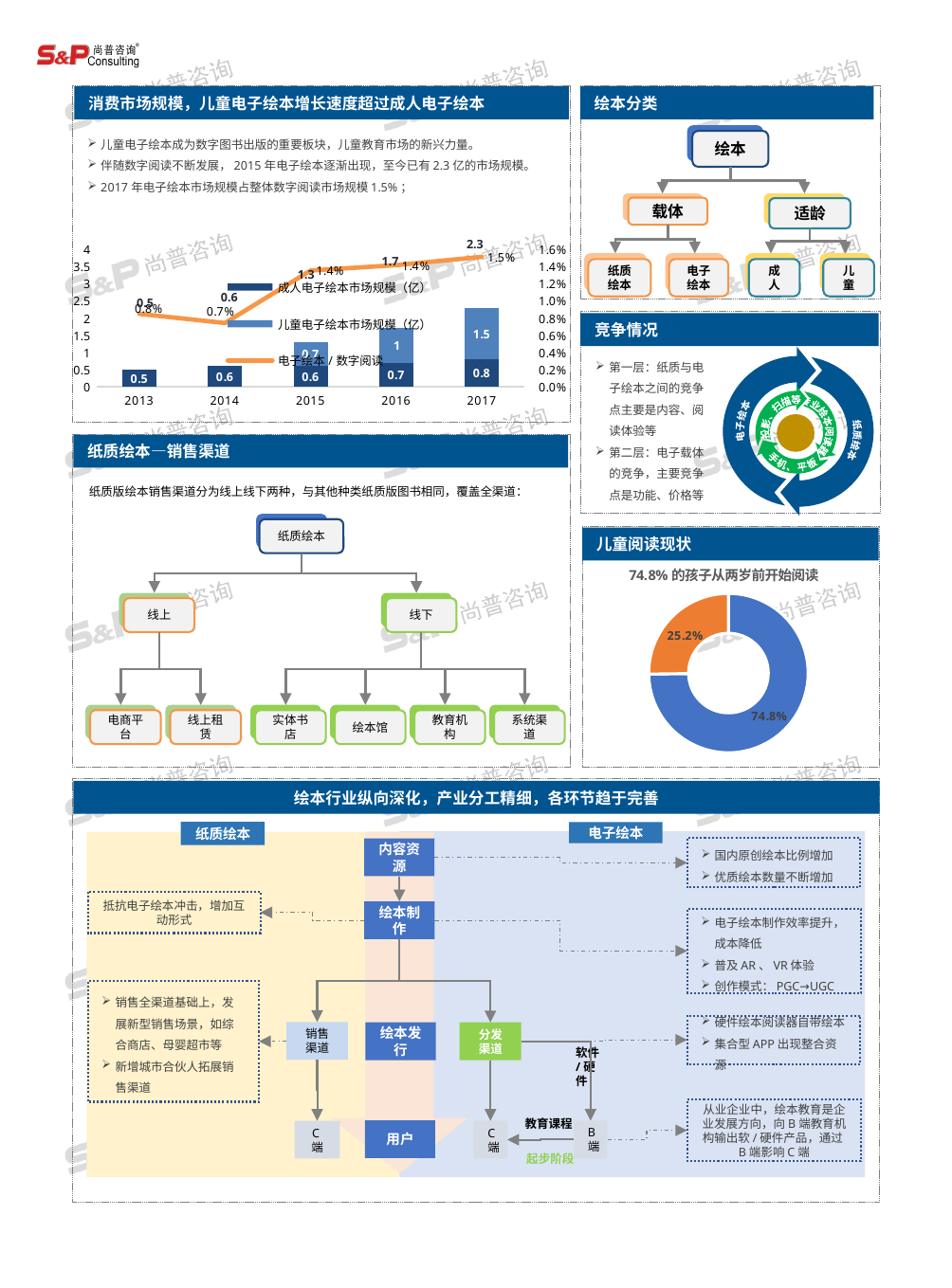
In the chart titled 消费市场规模，儿童电子绘本增长速度超过成人电子绘本, what is the difference between the 儿童电子绘本市场规模（亿） value in 2017 and in 2015? 0.8 In the chart titled 消费市场规模，儿童电子绘本增长速度超过成人电子绘本, which year has the highest value for 儿童电子绘本市场规模（亿）? 2017 In the chart titled 消费市场规模，儿童电子绘本增长速度超过成人电子绘本, what is the value of 电子绘本 / 数字阅读 in 2014? 0.7% In the chart titled 消费市场规模，儿童电子绘本增长速度超过成人电子绘本, how many years are shown on the x axis? 5 In the chart titled 消费市场规模，儿童电子绘本增长速度超过成人电子绘本, which is larger in 2016: 成人电子绘本市场规模（亿） or 儿童电子绘本市场规模（亿）? 儿童电子绘本市场规模（亿） In the chart titled 消费市场规模，儿童电子绘本增长速度超过成人电子绘本, what is the total of the stacked bar for 2017? 2.3 What kind of chart is shown under 儿童阅读现状? donut chart In the chart titled 消费市场规模，儿童电子绘本增长速度超过成人电子绘本, what is the value of 成人电子绘本市场规模（亿） in 2017? 0.8 In the chart titled 消费市场规模，儿童电子绘本增长速度超过成人电子绘本, what is the value of 儿童电子绘本市场规模（亿） in 2016? 1 In the chart titled 消费市场规模，儿童电子绘本增长速度超过成人电子绘本, how many series does the legend list? 3 In the chart under 儿童阅读现状, what share does the larger slice represent? 74.8% In the chart titled 消费市场规模，儿童电子绘本增长速度超过成人电子绘本, does the 电子绘本 / 数字阅读 line rise or fall from 2014 to 2017? rise